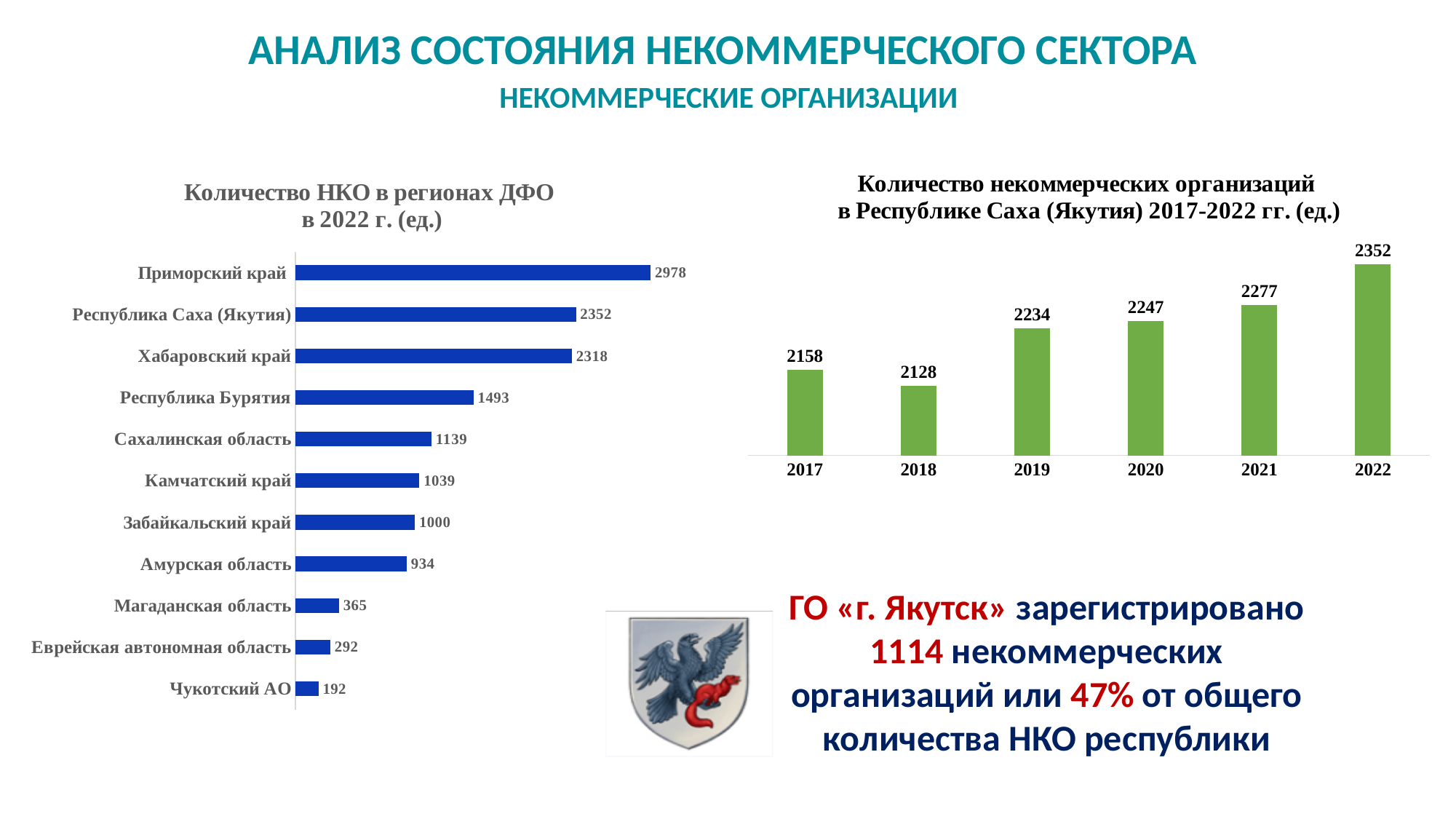
In the chart 'Количество некоммерческих организаций в Республике Саха (Якутия) 2017-2022 гг. (ед.)', which year has the lowest value? 2018 In the chart 'Количество НКО в регионах ДФО в 2022 г. (ед.)', which region has the lowest value? Чукотский АО What type of chart is 'Количество НКО в регионах ДФО в 2022 г. (ед.)'? Bar chart In the chart 'Количество некоммерческих организаций в Республике Саха (Якутия) 2017-2022 гг. (ед.)', what is the difference between 2022 and 2017? 194 In the chart 'Количество НКО в регионах ДФО в 2022 г. (ед.)', how many regions are shown? 11 In the chart 'Количество некоммерческих организаций в Республике Саха (Якутия) 2017-2022 гг. (ед.)', what is the value for 2019? 2234 In the chart 'Количество некоммерческих организаций в Республике Саха (Якутия) 2017-2022 гг. (ед.)', do the values rise or fall from 2018 to 2022? Rise In the chart 'Количество НКО в регионах ДФО в 2022 г. (ед.)', what is the value for Хабаровский край? 2318 In the chart 'Количество НКО в регионах ДФО в 2022 г. (ед.)', which region has the highest value? Приморский край In the chart 'Количество некоммерческих организаций в Республике Саха (Якутия) 2017-2022 гг. (ед.)', how many years are shown? 6 In the chart 'Количество НКО в регионах ДФО в 2022 г. (ед.)', what is the difference between Приморский край and Республика Саха (Якутия)? 626 In the chart 'Количество НКО в регионах ДФО в 2022 г. (ед.)', which is larger: Сахалинская область or Камчатский край? Сахалинская область